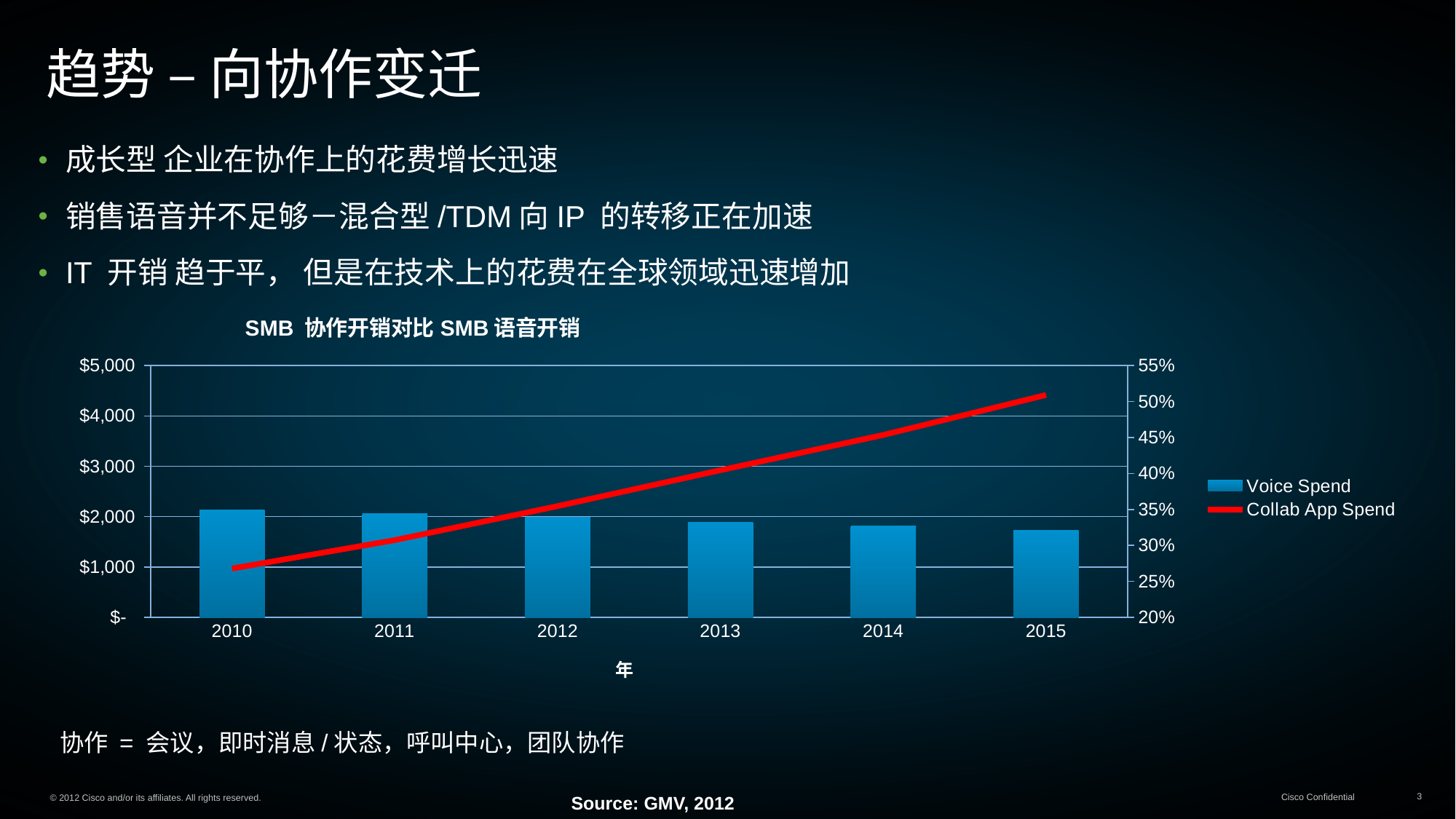
Is the Voice Spend value for 2015 greater or less than $2,000? less How many years are shown on the x axis? 6 What kind of chart is shown on the slide? A combined bar and line chart Which year has the highest Voice Spend bar? 2010 How many series does the legend list? 2 Is the Collab App Spend value for 2015 greater or less than 45%? greater Which year has the lowest Voice Spend bar? 2015 Does Collab App Spend rise or fall from 2010 to 2015? rise Is the Collab App Spend value for 2010 greater or less than 30%? less Does Voice Spend rise or fall from 2010 to 2015? fall Is Voice Spend higher in 2010 or in 2015? 2010